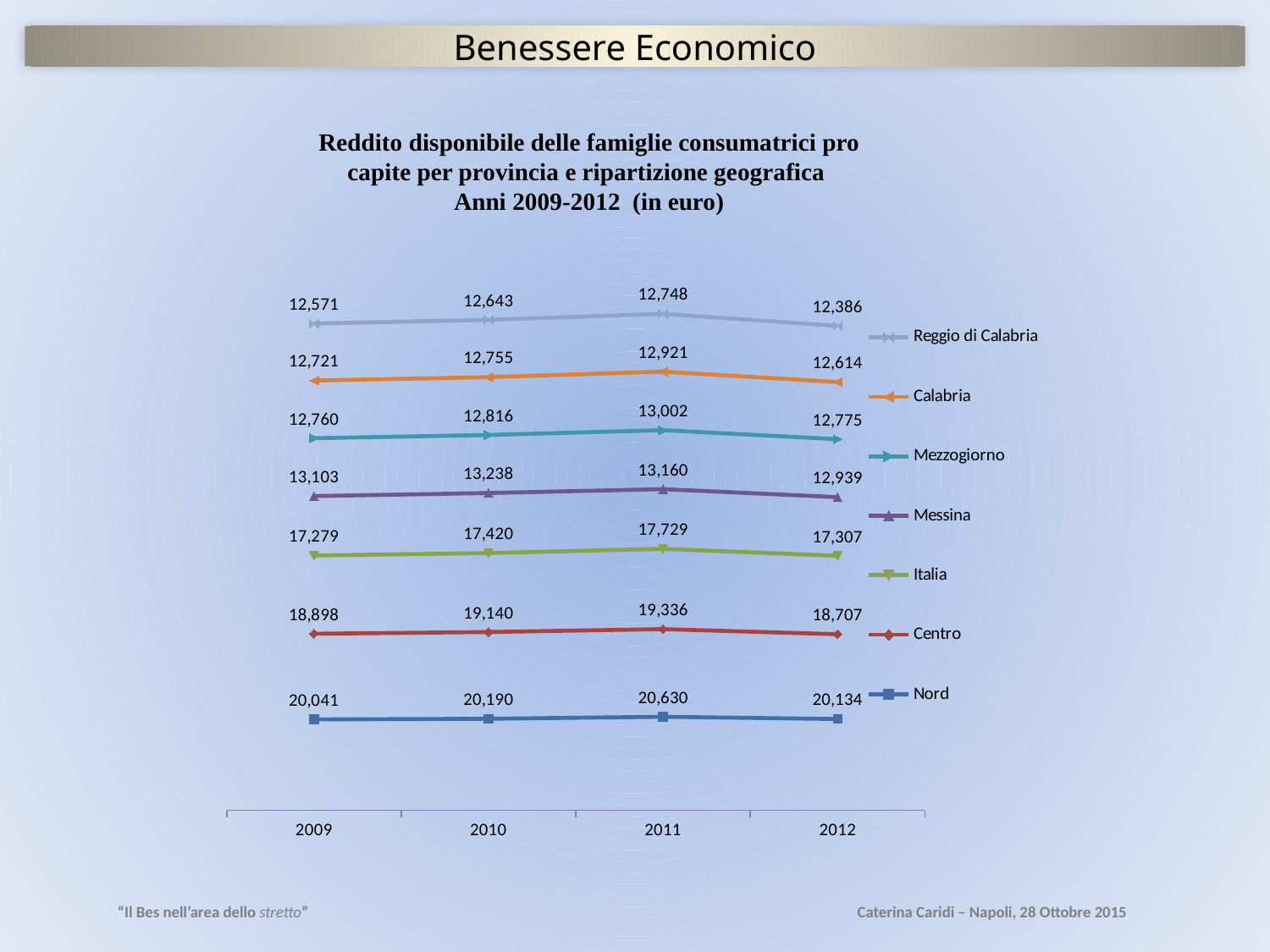
In which year is the value for Reggio di Calabria lowest? 2012 What kind of chart is this? Line chart Which series has the highest value in 2009? Nord Which is larger in 2012, Calabria or Mezzogiorno? Mezzogiorno What is the difference between Nord and Centro in 2011? 1,294 How many series does the legend list? 7 In which year is the value for Centro highest? 2011 How many years are shown on the x axis? 4 What is the value for Reggio di Calabria in 2011? 12,748 What is the value for Italia in 2010? 17,420 By how much did the value for Messina change from 2009 to 2010? 135 What is the value for Nord in 2012? 20,134